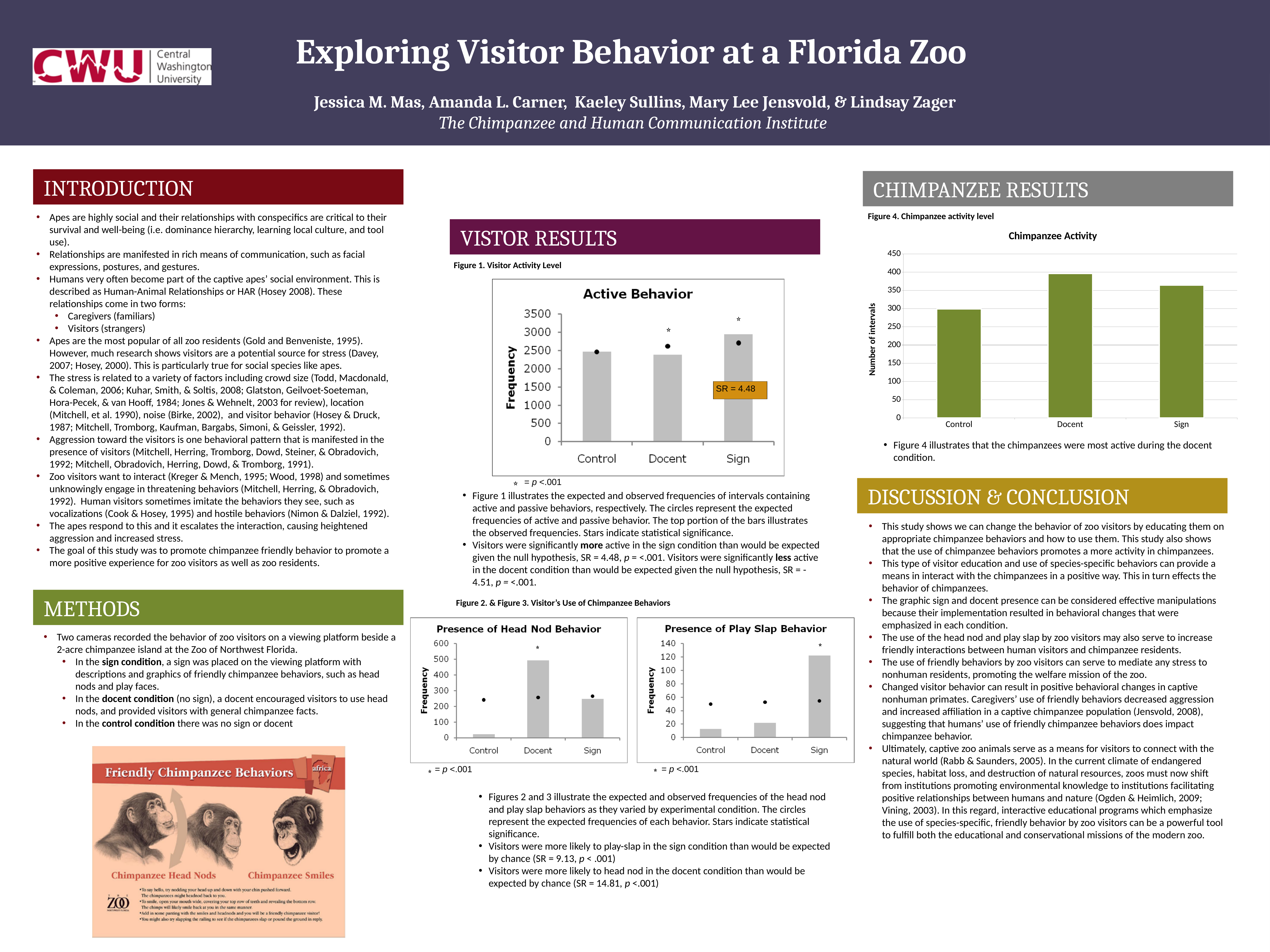
In the Active Behavior chart, is the value for Sign greater or less than 2500? greater In the Chimpanzee Activity chart, which condition has the highest bar? Docent In the Presence of Play Slap Behavior chart, is the value for Sign greater or less than 100? greater In the Presence of Head Nod Behavior chart, which condition has the highest bar? Docent In the Presence of Head Nod Behavior chart, which condition has the lowest bar? Control In the Chimpanzee Activity chart, is the value for Docent greater or less than 350? greater In the Presence of Play Slap Behavior chart, which is larger, the bar for Docent or the bar for Sign? Sign How many conditions are shown on the x axis of the Chimpanzee Activity chart? 3 In the Presence of Play Slap Behavior chart, which condition has the highest bar? Sign